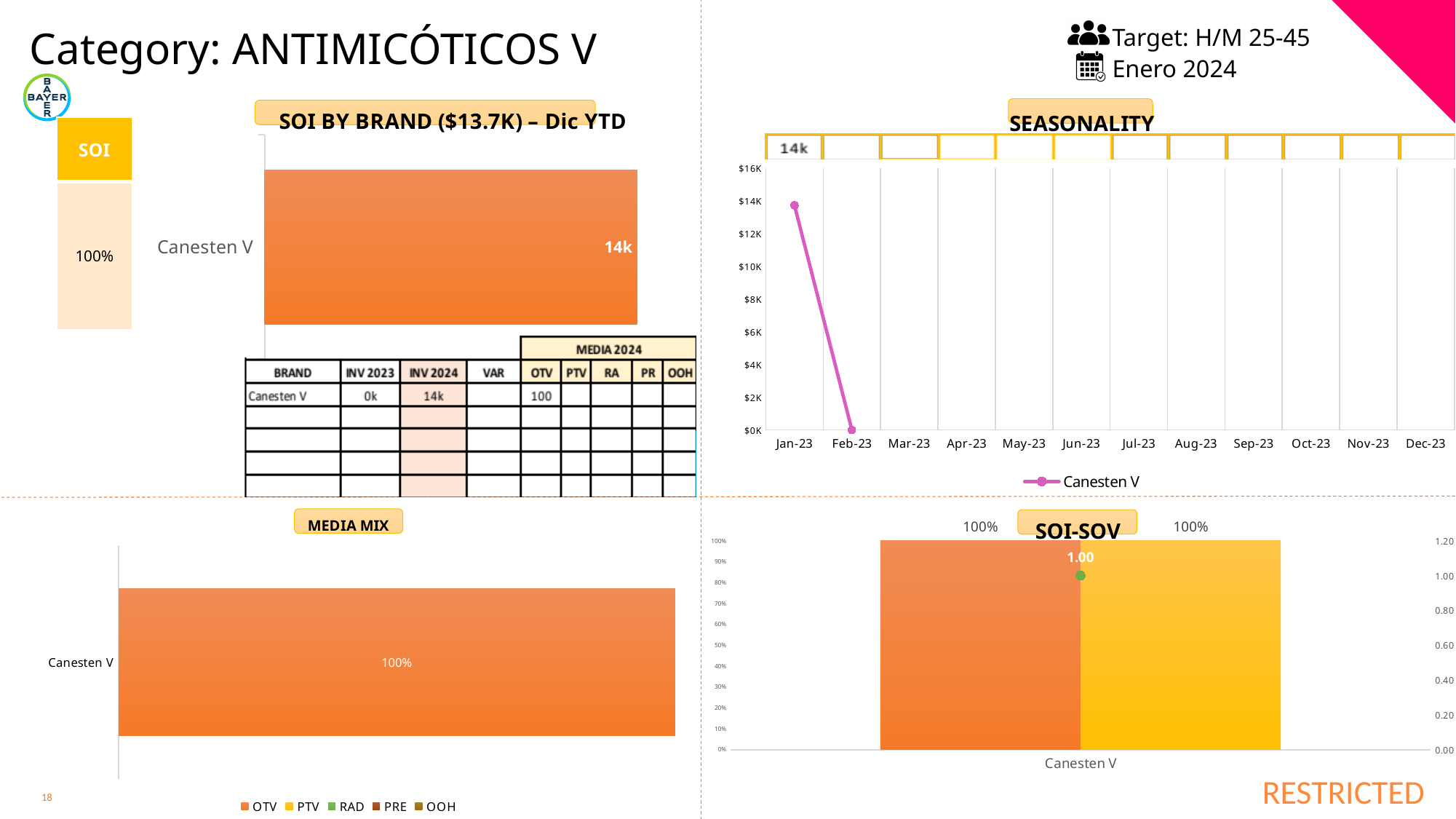
In the SOI BY BRAND chart, what is the value shown for Canesten V? 14k In the SOI-SOV chart, what value is labelled on the point above Canesten V? 1.00 How many months are shown on the x axis of the SEASONALITY chart? 12 What kind of chart is the SEASONALITY chart? line chart In the SEASONALITY chart, is the value for Jan-23 greater or less than $12K? greater In the SEASONALITY chart, what is the value for Feb-23? $0K What kind of chart is the SOI BY BRAND chart? bar chart In the MEDIA MIX chart, what percentage is shown for Canesten V? 100% How many media types does the legend of the MEDIA MIX chart list? 5 How many brands are plotted in the SOI BY BRAND chart? 1 How many series does the legend of the SEASONALITY chart list? 1 In the SEASONALITY chart, does the Canesten V line rise or fall from Jan-23 to Feb-23? fall